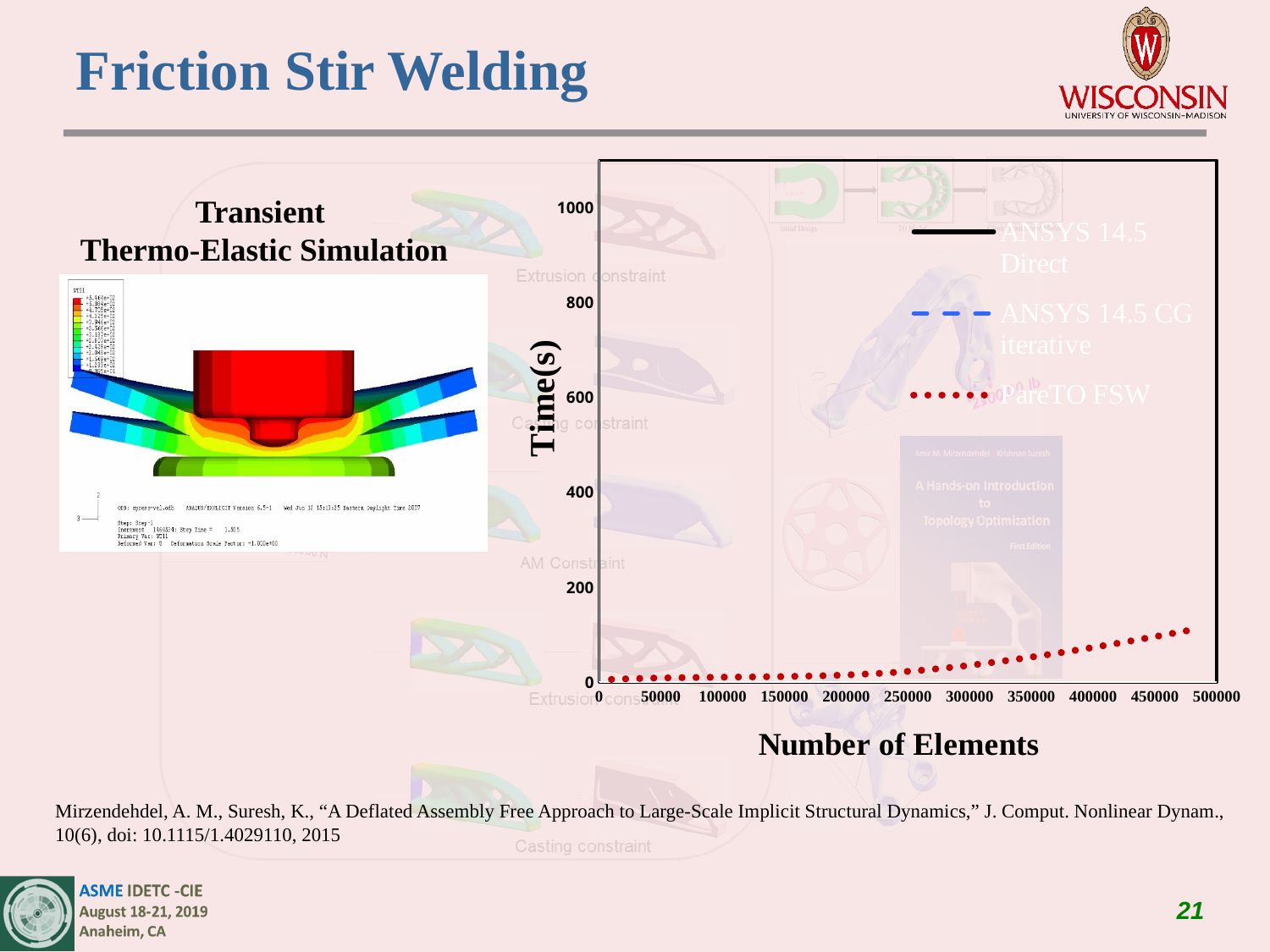
What is the highest value shown on the chart's x axis? 500000 How many series does the chart's legend list? 3 Is the ParetO FSW time at 100000 elements greater or less than 200 seconds? less Is the ParetO FSW time at 450000 elements greater or less than 200 seconds? less What is the label of the chart's y axis? Time(s) What kind of chart is shown on the slide? line chart What is the label of the chart's x axis? Number of Elements Does the ParetO FSW series rise or fall as the number of elements increases? rise